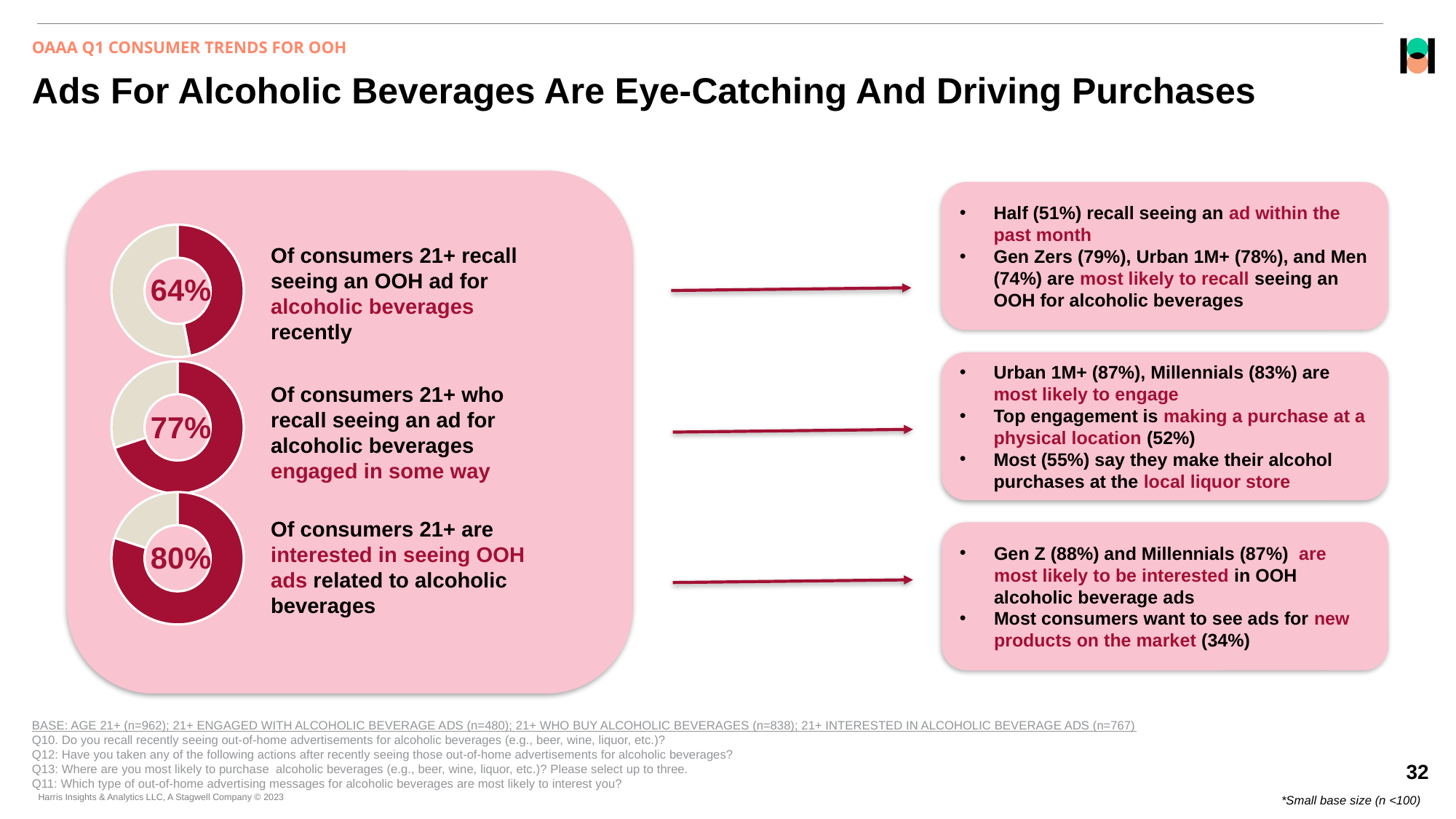
Which is larger: the percentage who engaged in some way (middle chart) or the percentage interested in seeing OOH ads (bottom chart)? Interested in seeing OOH ads (80%) What colour is used for the highlighted segment in each donut chart? Dark red What is the difference between the middle donut chart value and the top donut chart value? 13 percentage points What type of chart is used to display the three percentages on the left of the slide? Donut (pie) chart Which of the three donut charts shows the lowest percentage? The top chart (recall seeing an OOH ad recently), 64% What percentage of consumers 21+ recall seeing an OOH ad for alcoholic beverages recently, according to the top donut chart? 64% According to the bottom donut chart, what percentage of consumers 21+ are interested in seeing OOH ads related to alcoholic beverages? 80% How many donut charts are shown on the slide? 3 What is the difference in percentage points between the bottom donut chart (80%) and the top donut chart (64%)? 16 percentage points Which of the three donut charts shows the highest percentage? The bottom chart (interested in seeing OOH ads), 80% In the middle donut chart, what share of consumers 21+ who recall seeing an ad for alcoholic beverages engaged in some way? 77%